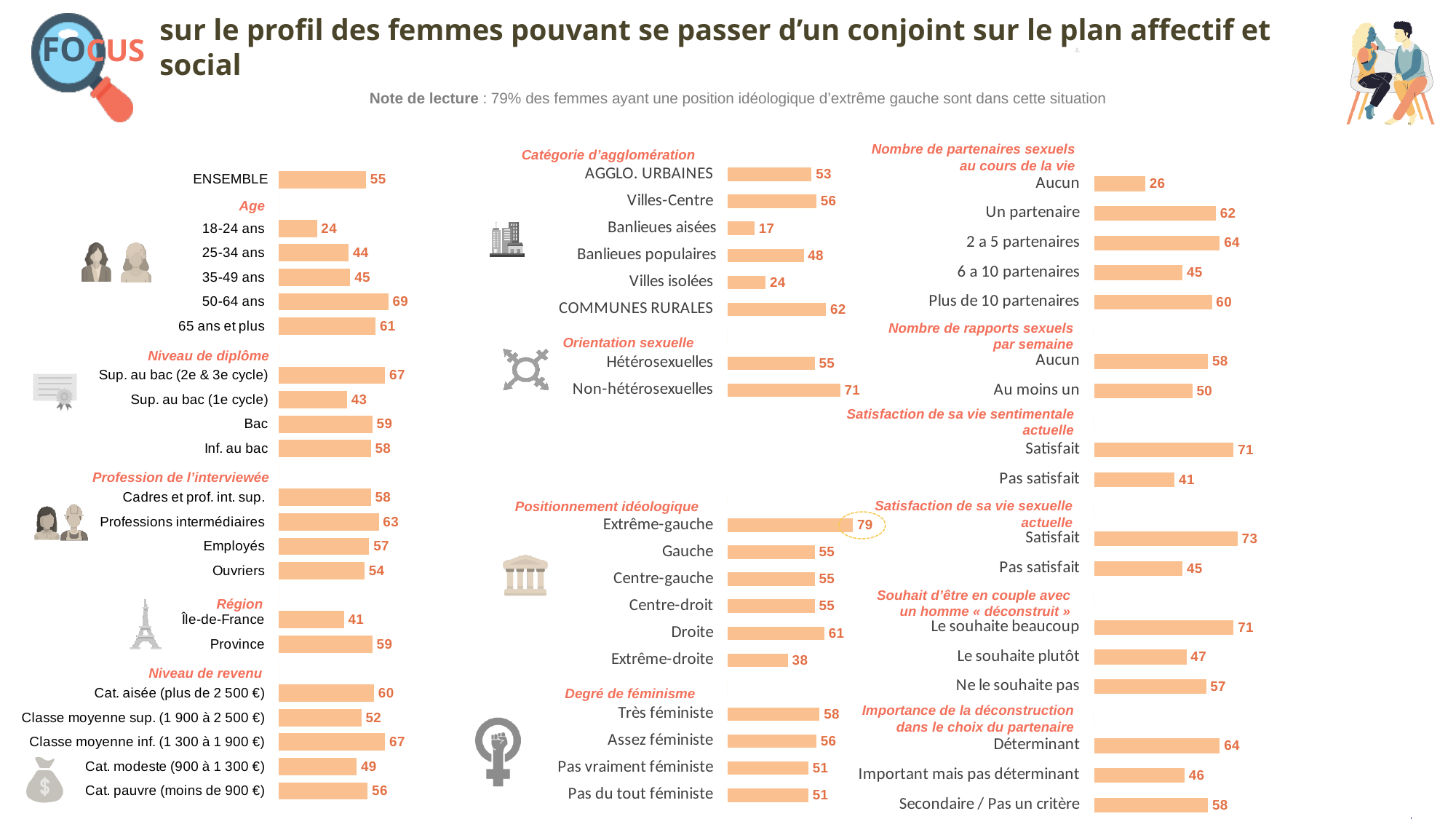
In the Catégorie d'agglomération chart, what is the difference between COMMUNES RURALES and Villes isolées? 38 What type of chart is used on this slide? Bar chart In the Age section of the left-hand chart, which age group has the lowest value? 18-24 ans In the Positionnement idéologique chart, what is the value for Extrême-droite? 38 In the Positionnement idéologique chart, which category has the highest value? Extrême-gauche In the Région section of the left-hand chart, what is the value for Île-de-France? 41 In the Catégorie d'agglomération chart, what is the value for Banlieues aisées? 17 In the left-hand chart, what is the value for ENSEMBLE? 55 In the Age section of the left-hand chart, which age group has the highest value? 50-64 ans In the Satisfaction de sa vie sexuelle actuelle chart, what is the difference between Satisfait and Pas satisfait? 28 In the Nombre de partenaires sexuels au cours de la vie chart, how many categories are shown? 5 In the Orientation sexuelle chart, which is larger: Hétérosexuelles or Non-hétérosexuelles? Non-hétérosexuelles